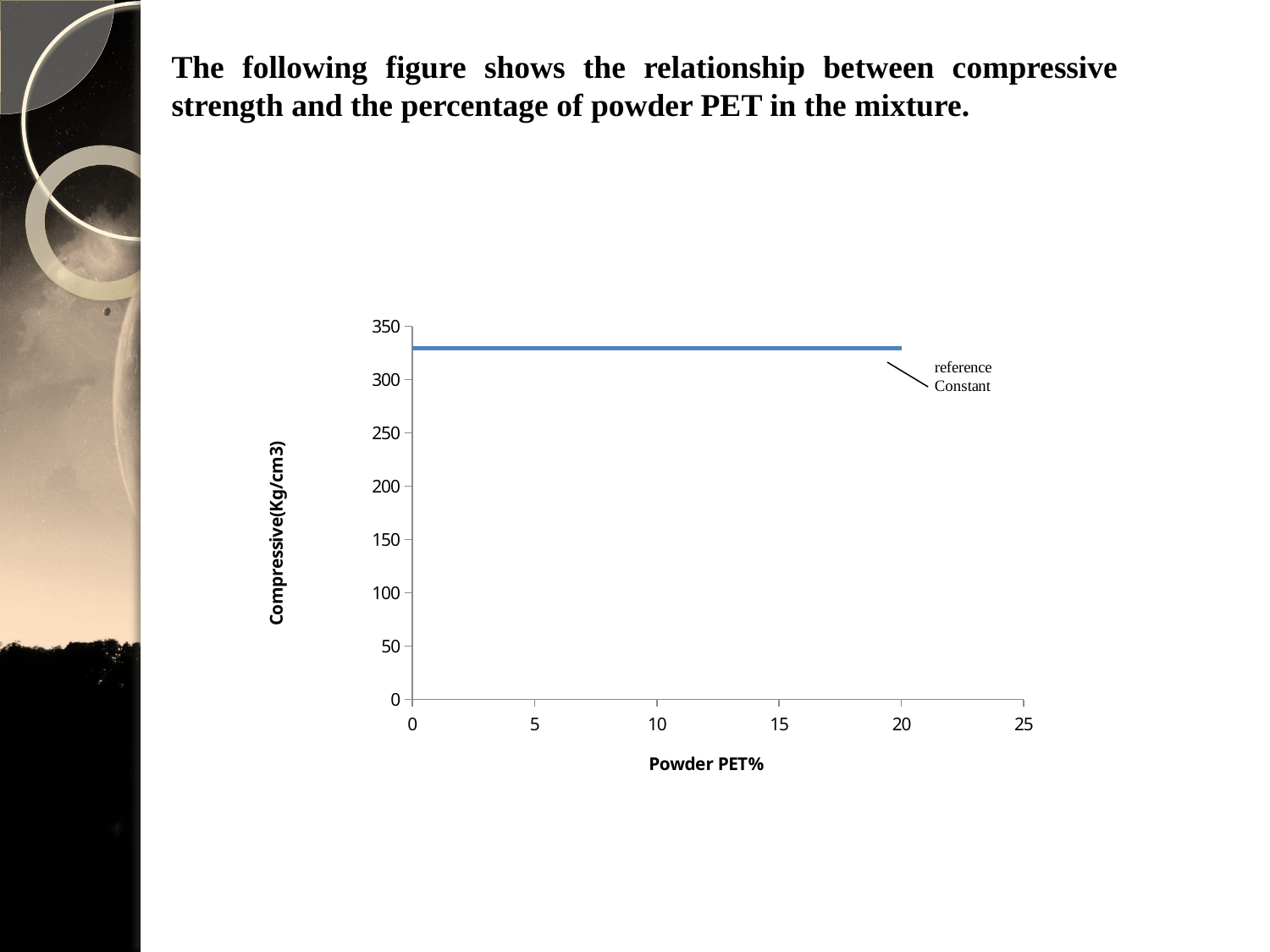
What is the highest tick value shown on the x axis? 25 What is the title of the x axis? Powder PET% What kind of chart is shown on the slide? line chart How many lines are plotted on the chart? 1 What is the title of the y axis? Compressive(Kg/cm3) Is the value of the plotted line at Powder PET% = 5 greater or less than 350? less Is the value of the plotted line at Powder PET% = 15 greater or less than 250? greater Does the plotted line rise, fall, or stay constant as Powder PET% increases from 0 to 20? stays constant Is the value of the plotted line at Powder PET% = 10 greater or less than 300? greater